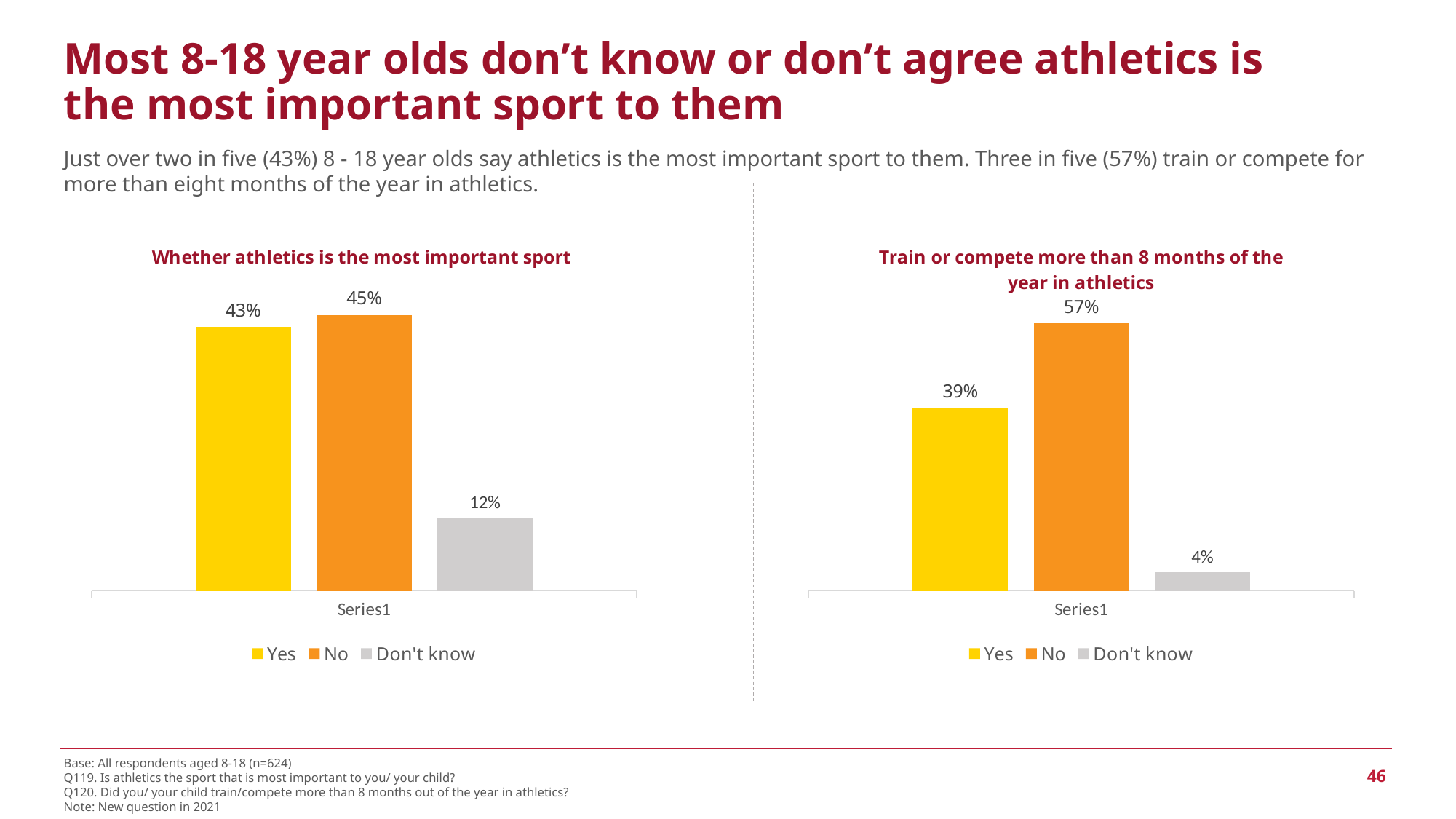
In the 'Train or compete more than 8 months of the year in athletics' chart, which is larger, Yes or No? No In the 'Train or compete more than 8 months of the year in athletics' chart, which response has the highest value? No In the 'Train or compete more than 8 months of the year in athletics' chart, what is the value for No? 57% In the 'Whether athletics is the most important sport' chart, what colour is the No bar? Orange In the 'Train or compete more than 8 months of the year in athletics' chart, what is the value for Don't know? 4% How many series does the legend of the 'Whether athletics is the most important sport' chart list? 3 In the 'Train or compete more than 8 months of the year in athletics' chart, what is the difference between No and Yes? 18% What kind of chart is the 'Train or compete more than 8 months of the year in athletics' chart? Bar chart In the 'Whether athletics is the most important sport' chart, which response has the lowest value? Don't know In the 'Whether athletics is the most important sport' chart, what is the difference between Yes and Don't know? 31% In the 'Whether athletics is the most important sport' chart, what is the value for Don't know? 12% In the 'Whether athletics is the most important sport' chart, what is the value for Yes? 43%